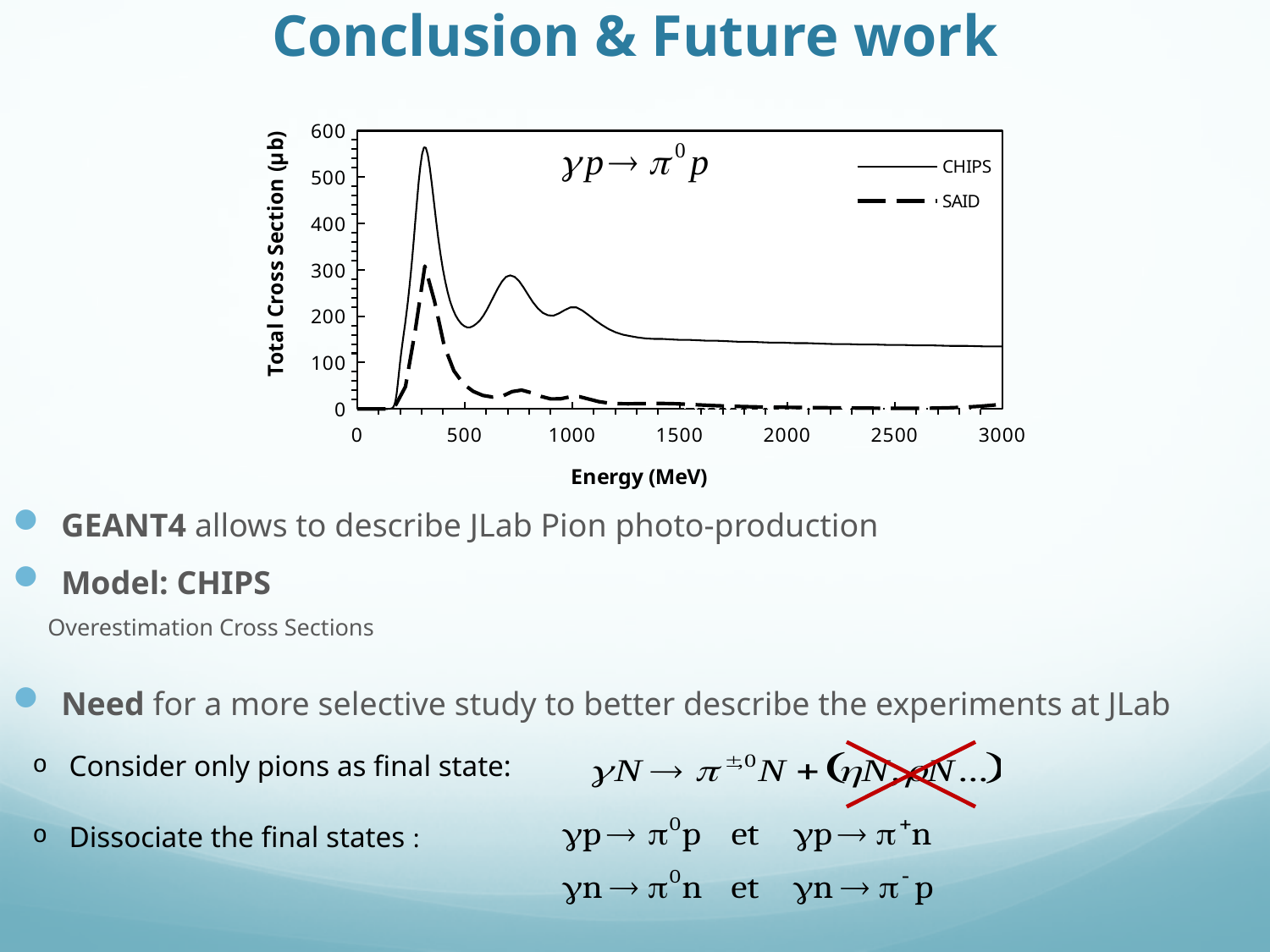
Is the value of the CHIPS curve at 3000 MeV greater or less than 100? greater Is the peak value of the CHIPS curve greater or less than 500? greater After its peak near 300 MeV, does the CHIPS curve rise or fall overall as energy increases toward 3000 MeV? fall Is the value of the CHIPS curve at 3000 MeV greater or less than 200? less What are the two series named in the chart legend? CHIPS and SAID What kind of chart is shown on the slide? line chart Which series reaches the higher peak value, CHIPS or SAID? CHIPS What is the title of the chart's y axis? Total Cross Section (μb) How many series does the chart legend list? 2